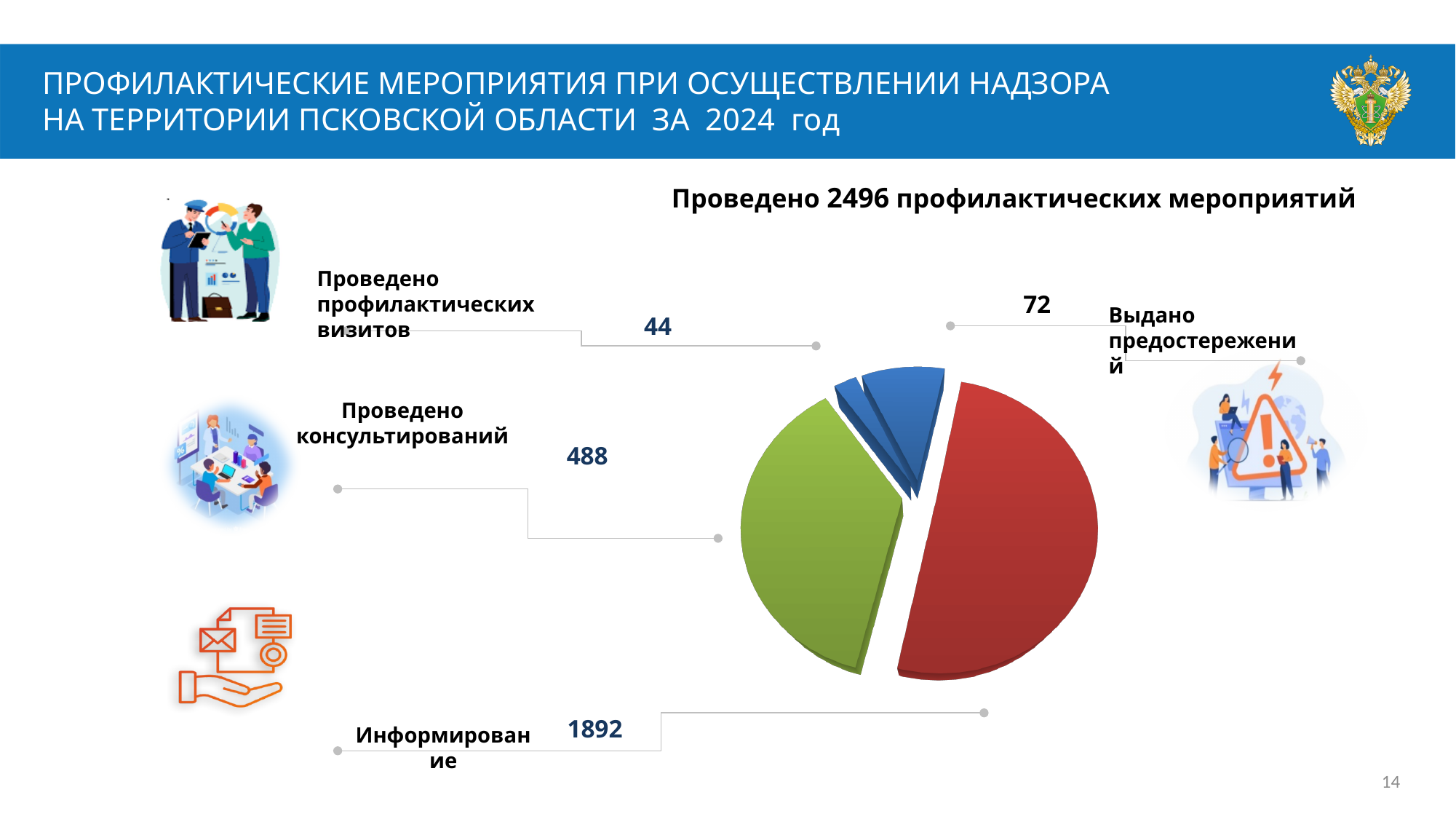
What is the value for 'Выдано предостережений'? 72 What is the total number of preventive measures stated above the pie chart? 2496 What is the value for 'Информирование'? 1892 What is the value for 'Проведено профилактических визитов'? 44 How many slices does the pie chart have? 4 What kind of chart is shown on the slide? pie chart Which is larger: 'Выдано предостережений' or 'Проведено профилактических визитов'? Выдано предостережений Which category has the lowest value in the pie chart? Проведено профилактических визитов What is the difference between the values for 'Информирование' and 'Проведено консультирований'? 1404 Which category has the highest value in the pie chart? Информирование What is the value for 'Проведено консультирований'? 488 Which colour is the largest slice of the pie chart? red